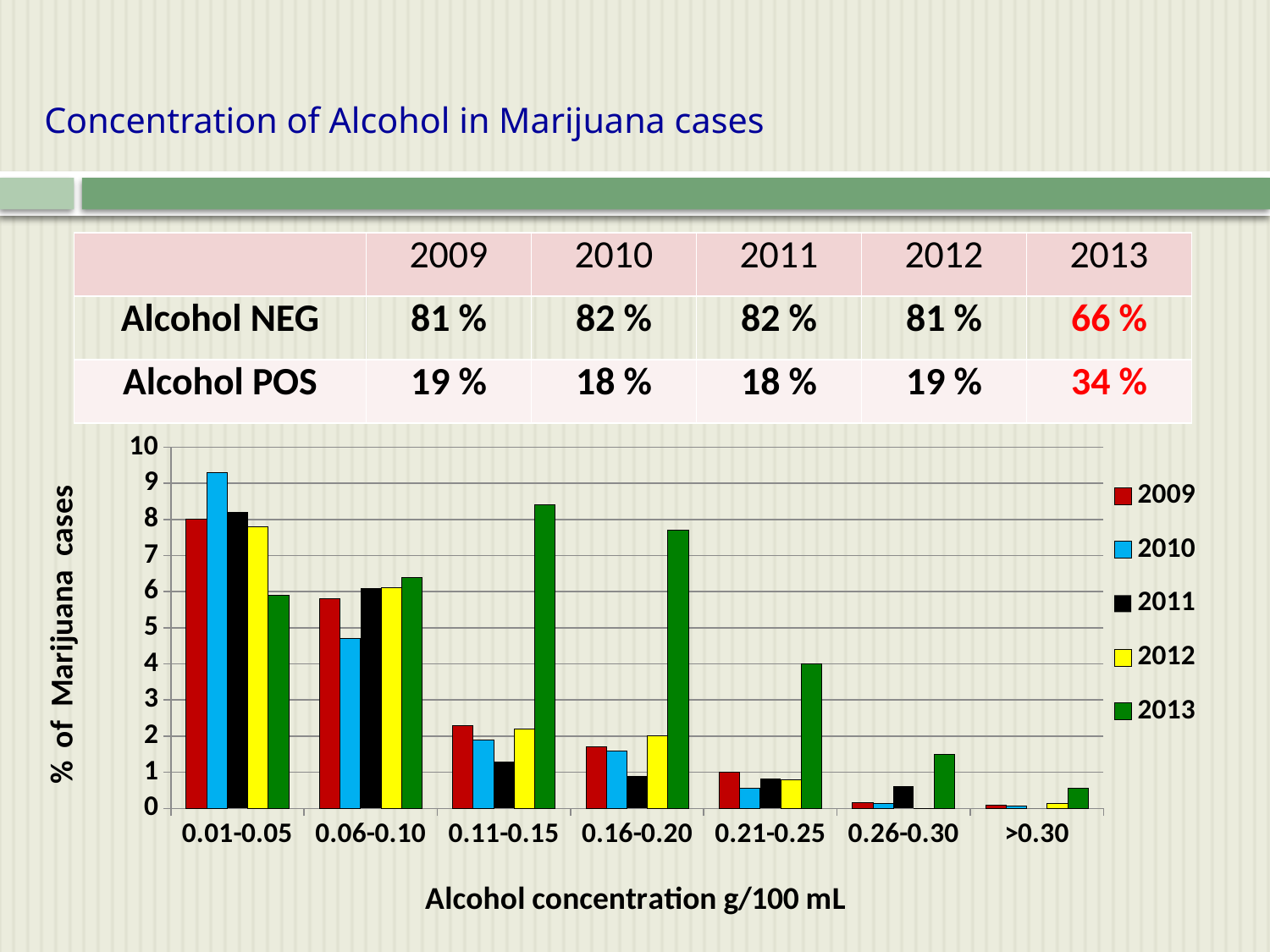
What kind of chart is shown on the slide? bar chart Do the values for the 2009 series rise or fall as alcohol concentration increases along the x axis? fall Which year has the highest value in the 0.16-0.20 category? 2013 Which year has the lowest value in the 0.01-0.05 category? 2013 In the 0.06-0.10 category, which is larger, the value for 2011 or the value for 2010? 2011 How many alcohol concentration categories are shown on the x axis of the chart? 7 Which year has the highest value in the 0.01-0.05 category? 2010 Is the value for 2013 in the 0.21-0.25 category greater or less than 3? greater Is the value for 2010 in the 0.01-0.05 category greater or less than 8? greater How many series does the chart legend list? 5 Is the value for 2013 in the 0.11-0.15 category greater or less than 7? greater What is the title of the x axis of the chart? Alcohol concentration g/100 mL